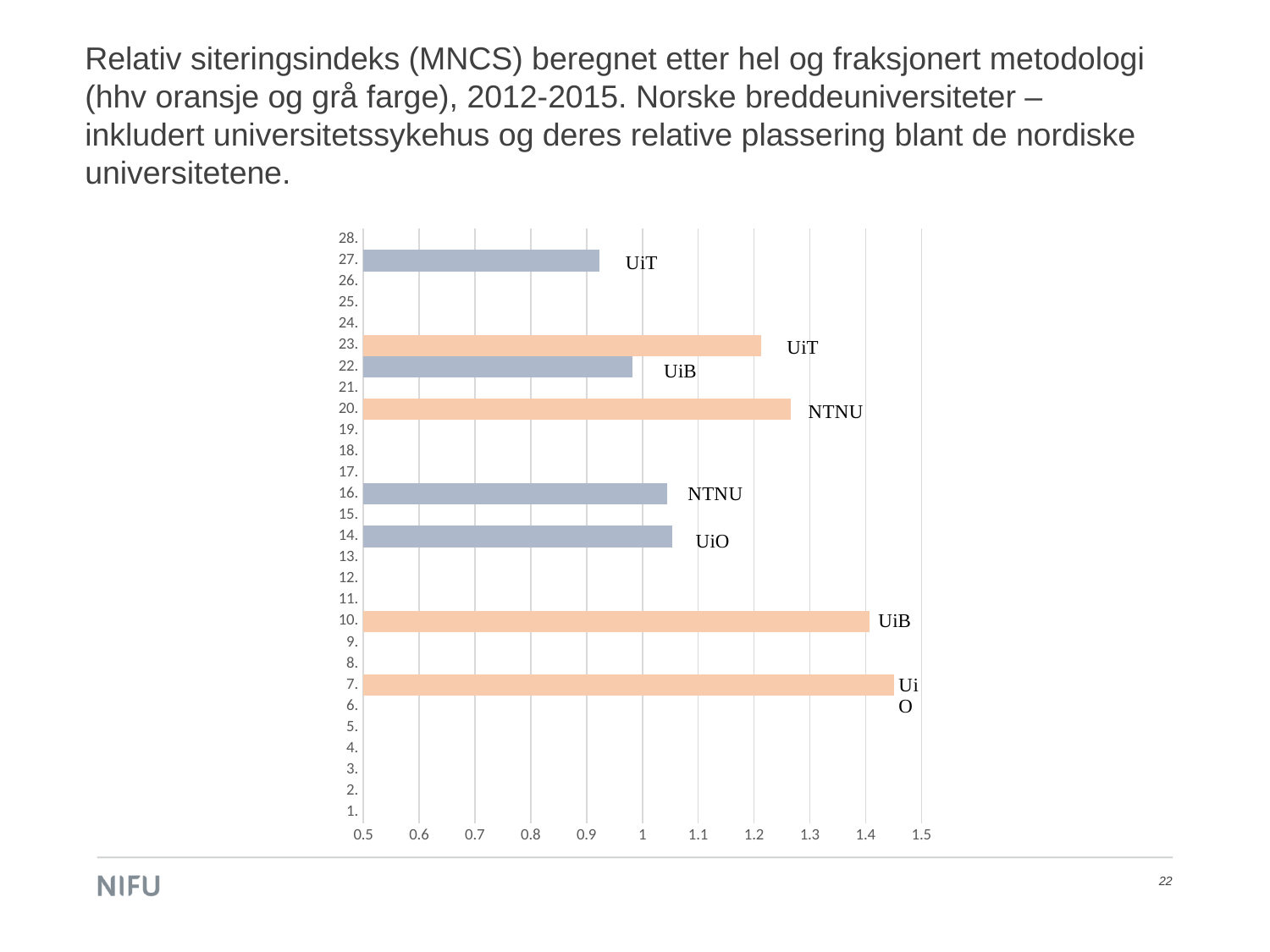
Is the value of the orange NTNU bar greater or less than 1.2? greater Is the value of the grey UiT bar greater or less than 1? less Which university has the shortest grey bar? UiT At which rank position on the vertical axis is the orange UiO bar placed? 7. What kind of chart is shown on the slide? bar chart How many bars are plotted in the chart? 8 Which orange bar is longer, NTNU or UiT? NTNU According to the slide title, which colour represents the whole-count (hel) methodology? orange Is the value of the orange UiB bar greater or less than 1.3? greater Which grey bar is longer, UiB or UiT? UiB Which university has the longest orange bar? UiO